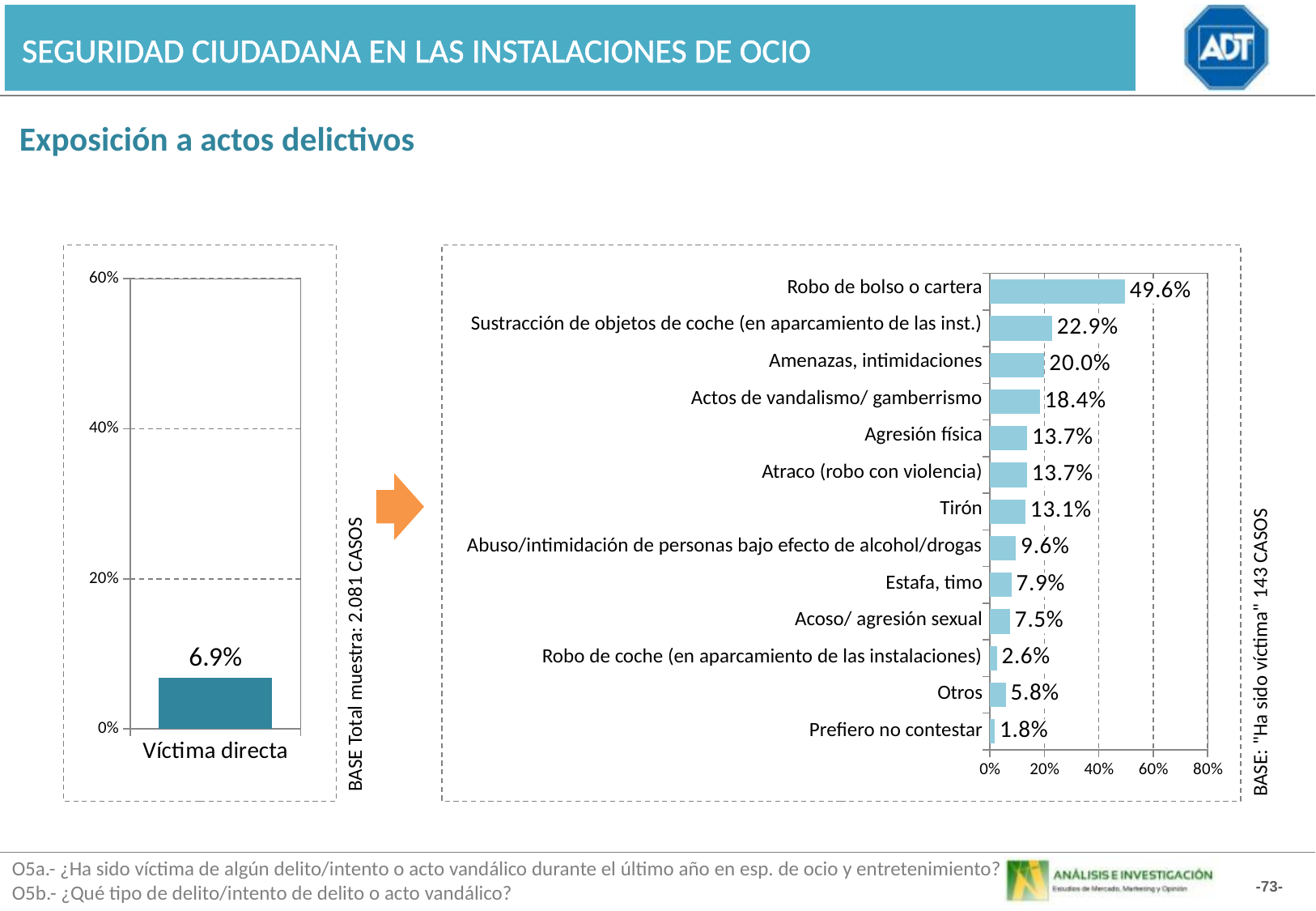
In the right chart, how many categories are shown? 13 In the right chart, what is the difference between Otros and Robo de coche (en aparcamiento de las instalaciones)? 3.2% In the right chart, which category has the lowest value? Prefiero no contestar In the right chart, what is the value for Robo de bolso o cartera? 49.6% What kind of chart is the right chart? Bar chart In the right chart, what is the value for Amenazas, intimidaciones? 20.0% In the right chart, what is the difference between Robo de bolso o cartera and Sustracción de objetos de coche (en aparcamiento de las inst.)? 26.7% In the left chart, what is the value for Víctima directa? 6.9% In the right chart, which category has the highest value? Robo de bolso o cartera In the left chart, is the value for Víctima directa greater or less than 20%? less In the right chart, what is the value for Estafa, timo? 7.9% In the right chart, which is larger: Tirón or Acoso/ agresión sexual? Tirón